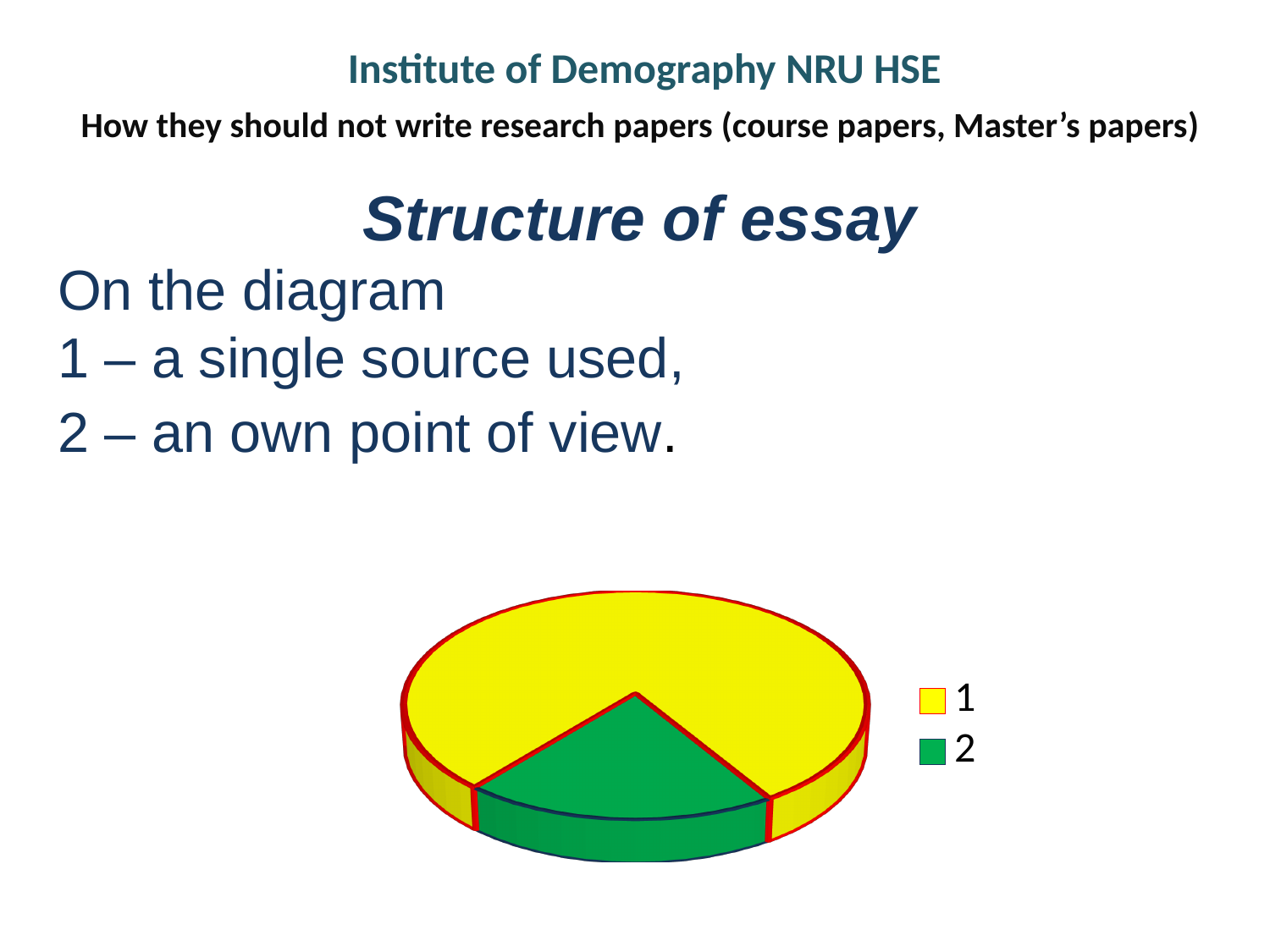
How many slices does the pie chart have? 2 What kind of chart is shown on the slide? pie chart Which slice of the pie chart is the largest? 1 Which slice is larger in the pie chart, 1 or 2? 1 How many entries does the legend of the pie chart list? 2 Which slice of the pie chart is the smallest? 2 What colour is slice 1 in the pie chart? yellow What colour is slice 2 in the pie chart? green